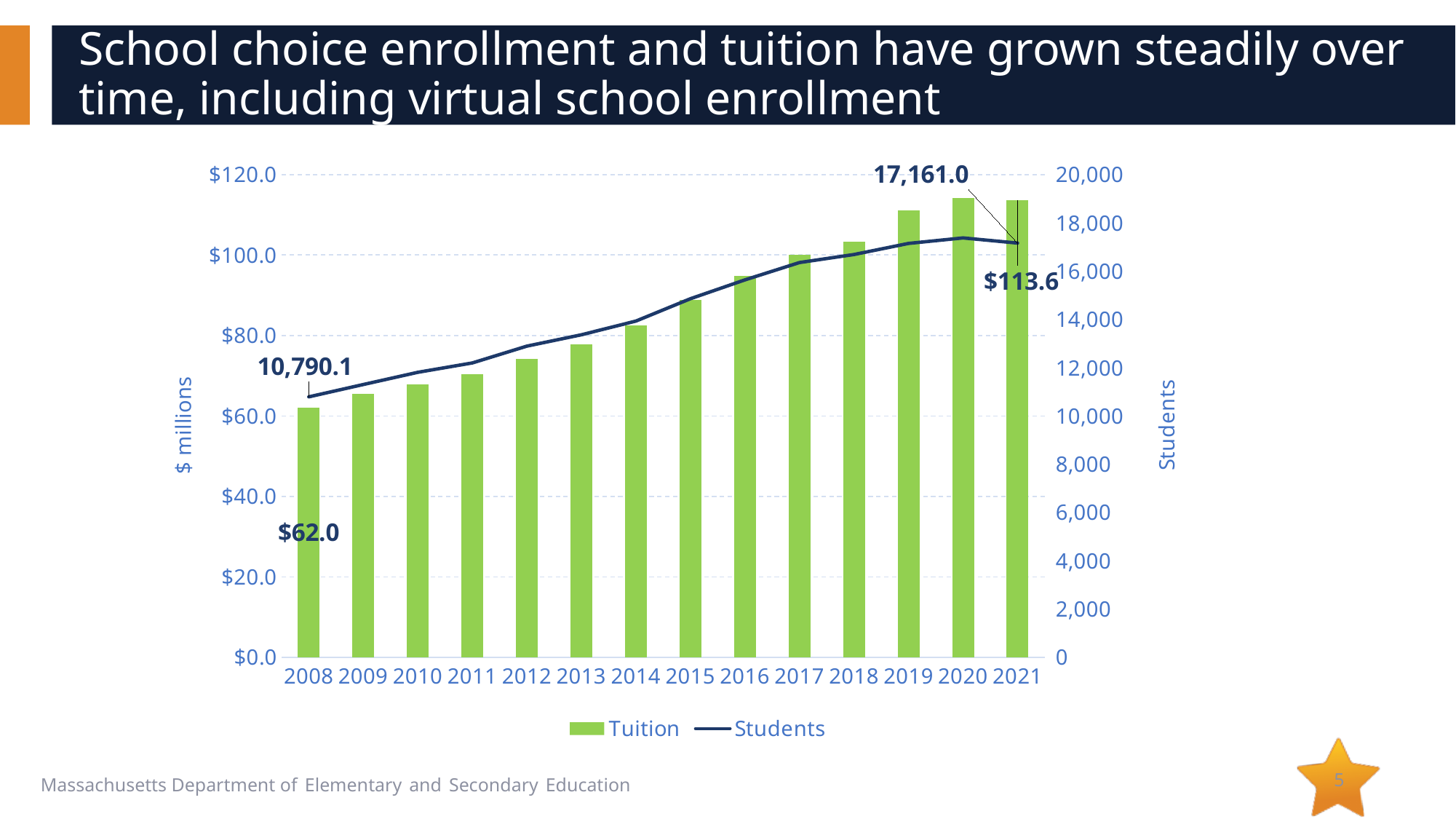
Is the Tuition value for 2016 greater or less than $80.0? greater What is the Tuition value for 2008? $62.0 Is the Tuition value for 2012 greater or less than $80.0? less How many years are shown on the x axis? 14 What is the Tuition value for 2021? $113.6 What is the Students value for 2021? 17,161.0 How many series does the legend list? 2 What is the Students value for 2008? 10,790.1 Which year has the lowest Tuition value? 2008 What kind of chart is shown on the slide? Combination bar and line chart What is the difference between the Tuition values for 2021 and 2008? $51.6 Is the Students value for 2011 greater or less than 10,000? greater